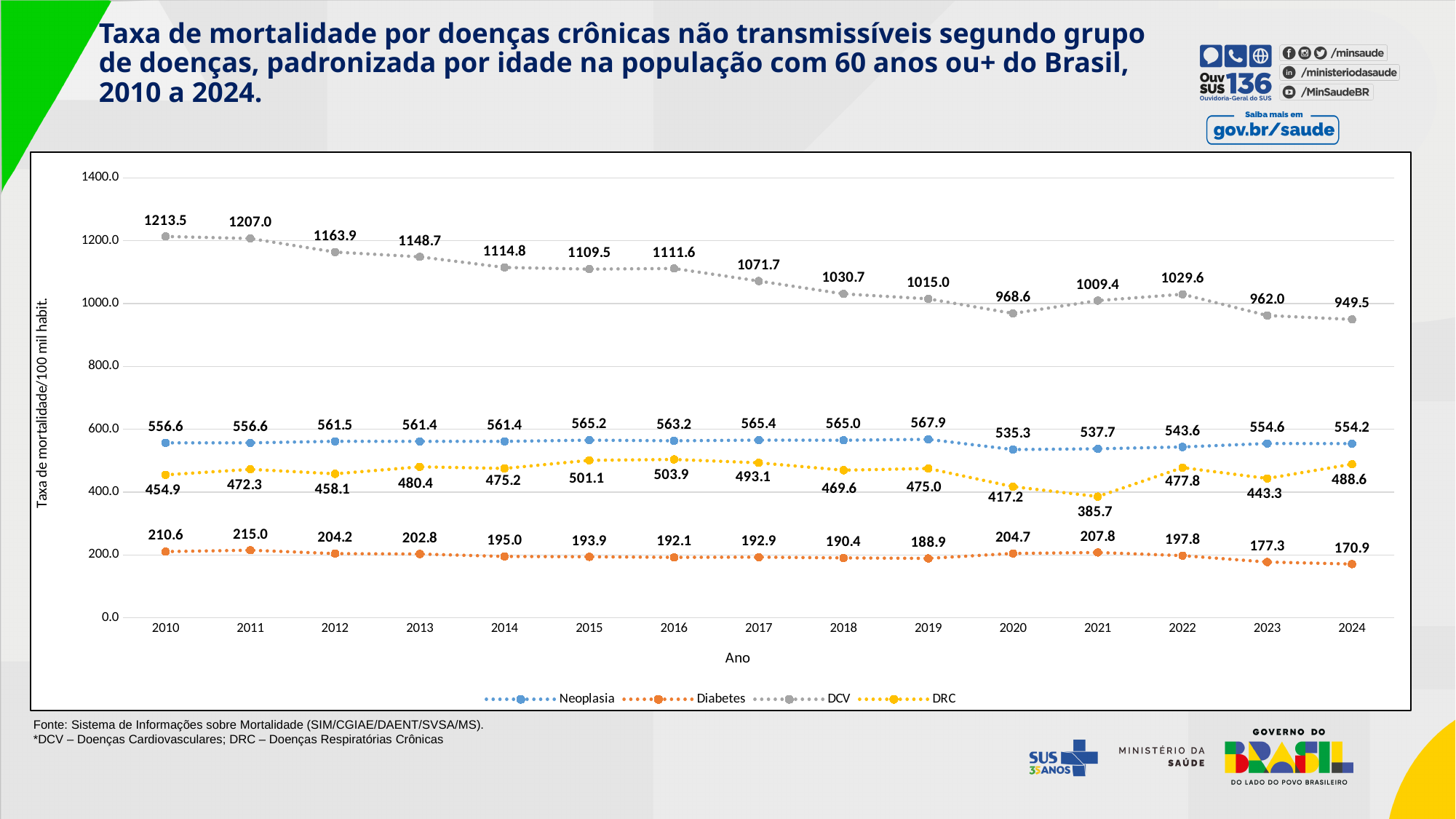
In which year is the DCV mortality rate highest? 2010 How many years are shown on the x axis? 15 Is the DCV value for 2024 greater or less than 1000.0? less In which year is the DRC mortality rate lowest? 2021 What is the Diabetes mortality rate in 2024? 170.9 Does the Diabetes mortality rate rise or fall from 2010 to 2024? fall What is the difference between the DCV rate in 2010 and in 2024? 264.0 What is the Neoplasia mortality rate in 2019? 567.9 How many series does the legend list? 4 Which year has the higher Neoplasia rate, 2019 or 2020? 2019 What is the DCV mortality rate in 2010? 1213.5 What kind of chart is shown on the slide? line chart